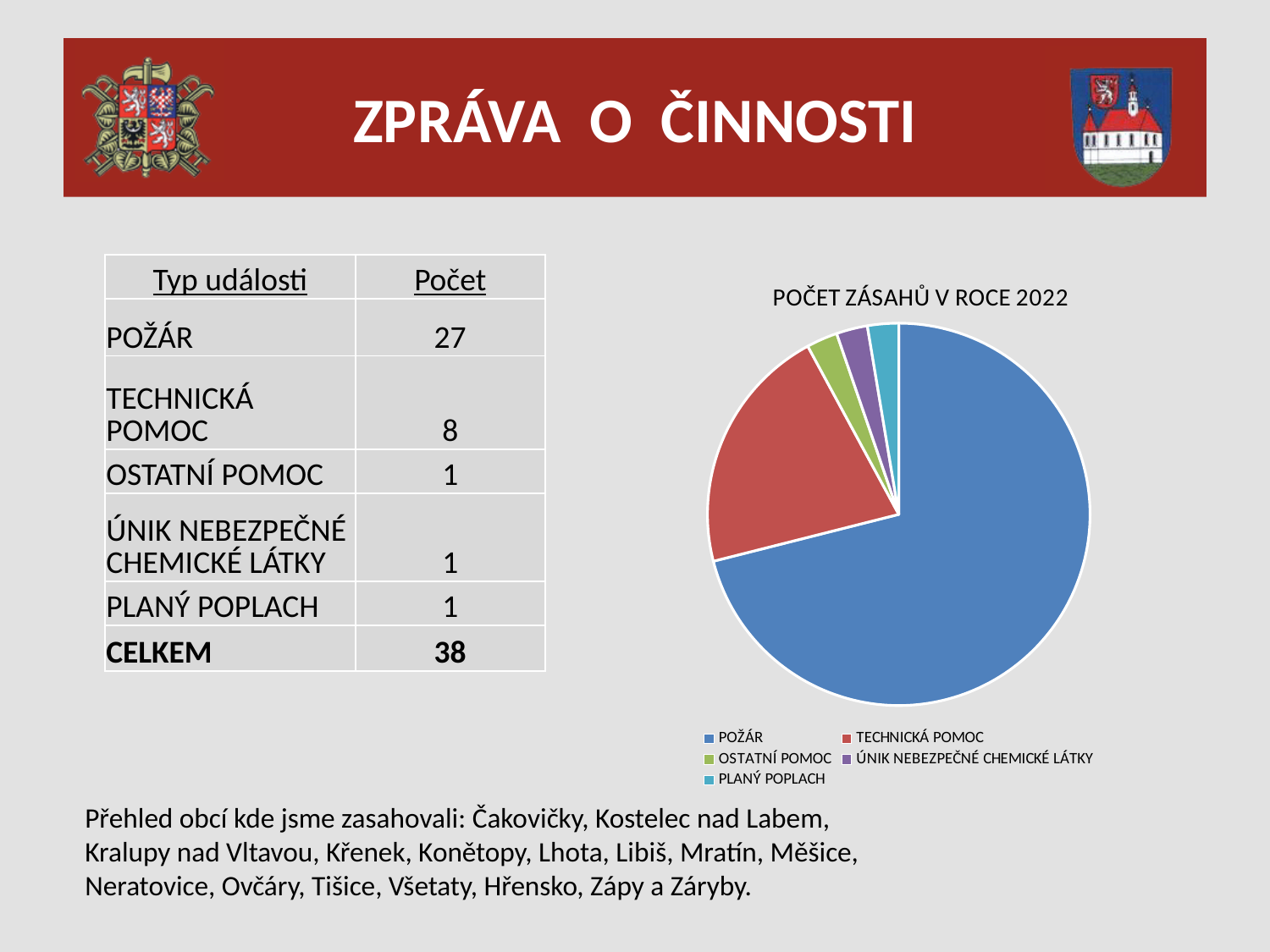
According to the table, how many events of type TECHNICKÁ POMOC were there? 8 What colour is the POŽÁR slice in the pie chart? blue What is the title of the pie chart? POČET ZÁSAHŮ V ROCE 2022 What kind of chart is shown on the slide? pie chart Which category has the largest slice in the pie chart? POŽÁR What is the difference between the number of POŽÁR events and TECHNICKÁ POMOC events? 19 According to the table, how many events of type PLANÝ POPLACH were there? 1 How many slices does the pie chart have? 5 Which slice is larger in the pie chart, POŽÁR or TECHNICKÁ POMOC? POŽÁR According to the table, how many events of type POŽÁR were there? 27 What is the total number of events (CELKEM) shown in the table? 38 How many entries does the pie chart's legend list? 5